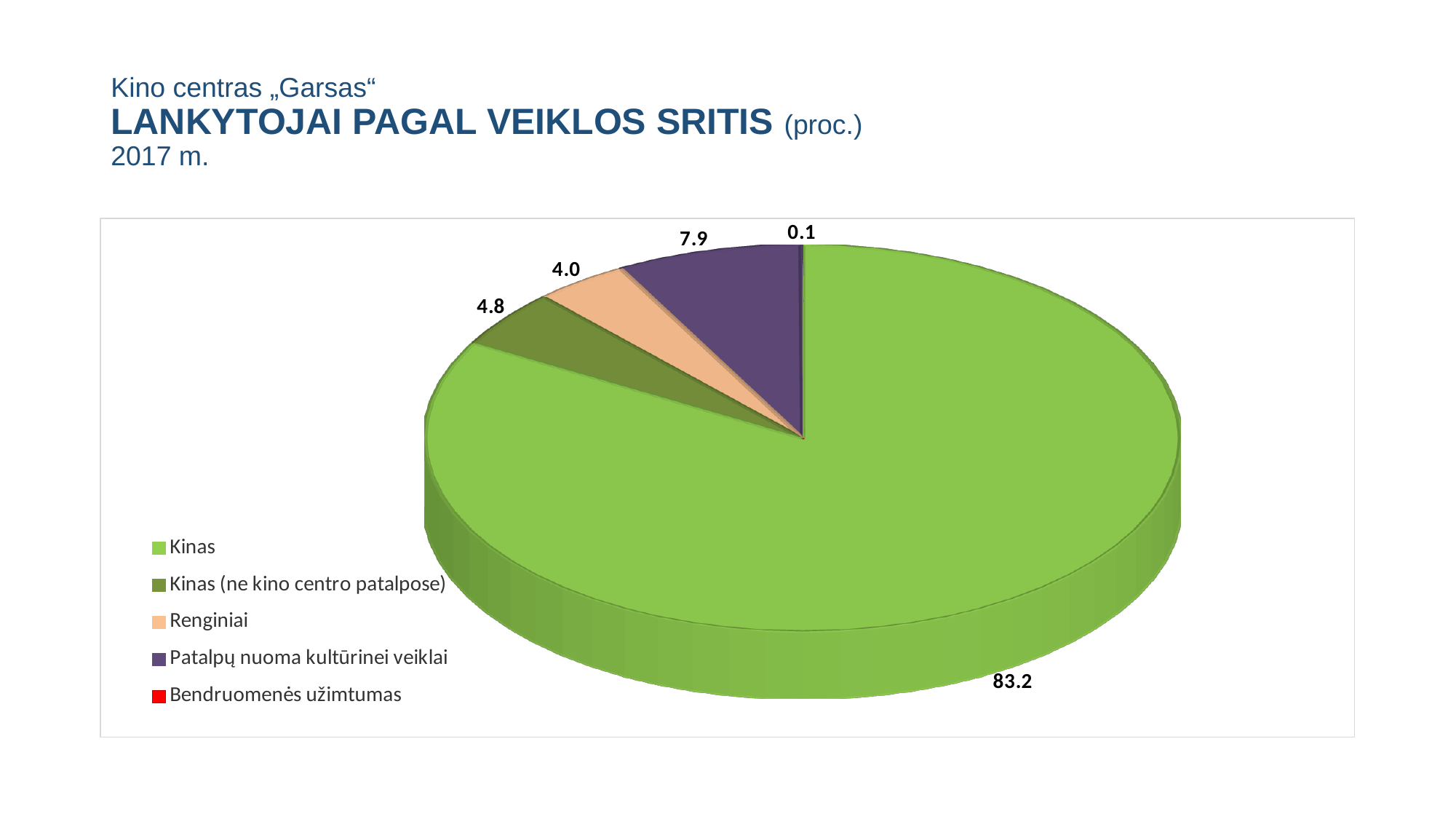
What is the difference between the values for Kinas (ne kino centro patalpose) and Renginiai? 0.8 Which is larger, Patalpų nuoma kultūrinei veiklai or Renginiai? Patalpų nuoma kultūrinei veiklai What is the value for Bendruomenės užimtumas? 0.1 How many categories does the legend list? 5 What type of chart is shown on the slide? pie chart What is the value for Patalpų nuoma kultūrinei veiklai? 7.9 What is the value for Kinas (ne kino centro patalpose)? 4.8 What is the value for Renginiai? 4.0 Which category has the largest share of the pie? Kinas Which category has the smallest share of the pie? Bendruomenės užimtumas What year does the chart title refer to? 2017 m. What is the value for Kinas? 83.2